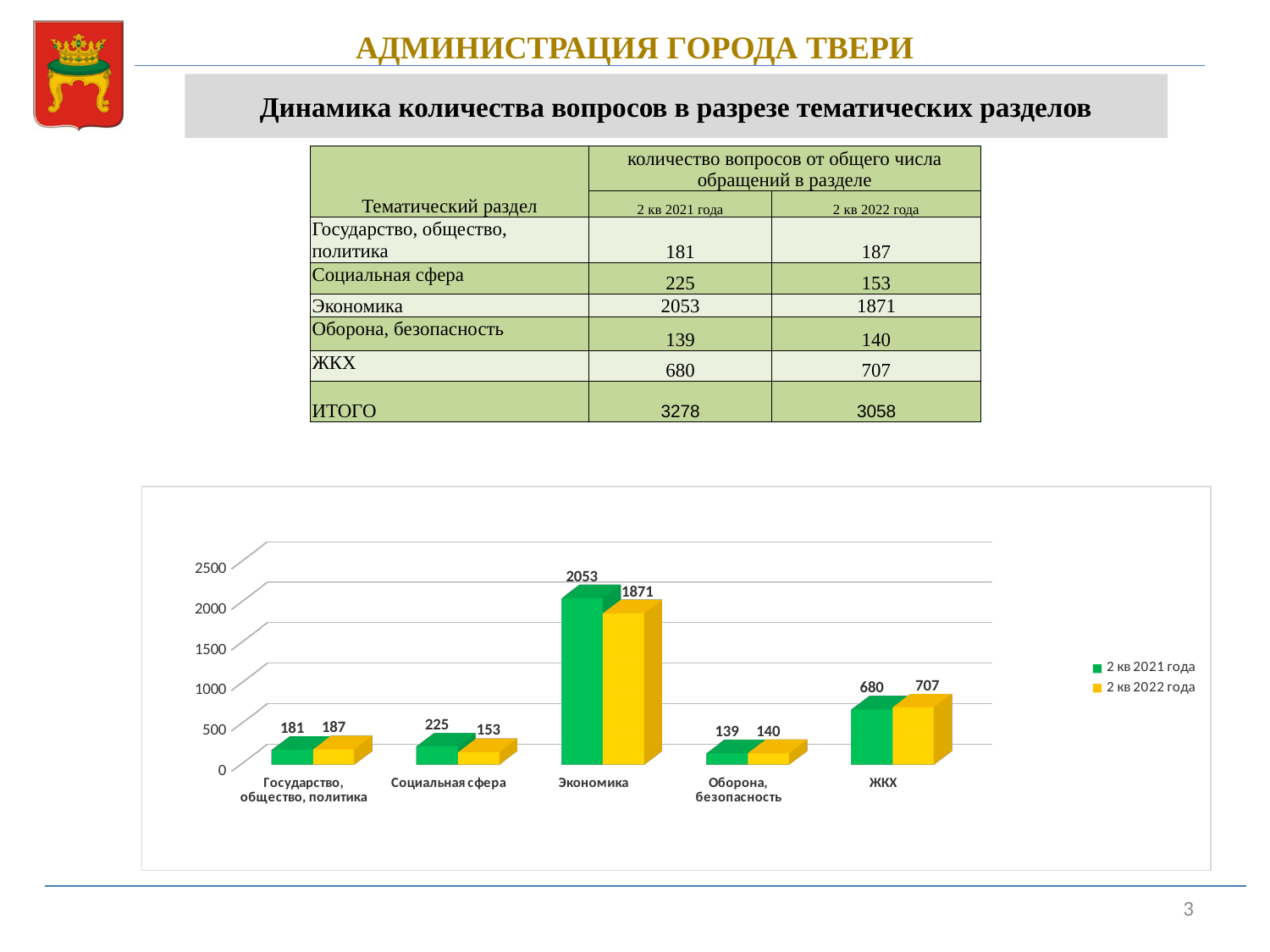
Which category has the highest value in the 2 кв 2021 года series? Экономика Which category has the lowest value in the 2 кв 2022 года series? Оборона, безопасность What is the difference between the 2 кв 2021 года and 2 кв 2022 года values for Экономика? 182 What is the value for ЖКХ in the 2 кв 2022 года series? 707 What colour represents the 2 кв 2022 года series in the chart? yellow What kind of chart is shown on the slide? bar chart How many series does the chart legend list? 2 What is the value for Экономика in the 2 кв 2021 года series? 2053 What is the value for Социальная сфера in the 2 кв 2022 года series? 153 How many categories are shown on the x axis of the chart? 5 Which is larger for Социальная сфера: the 2 кв 2021 года value or the 2 кв 2022 года value? 2 кв 2021 года Is the value for ЖКХ in 2 кв 2021 года greater or less than 500? greater